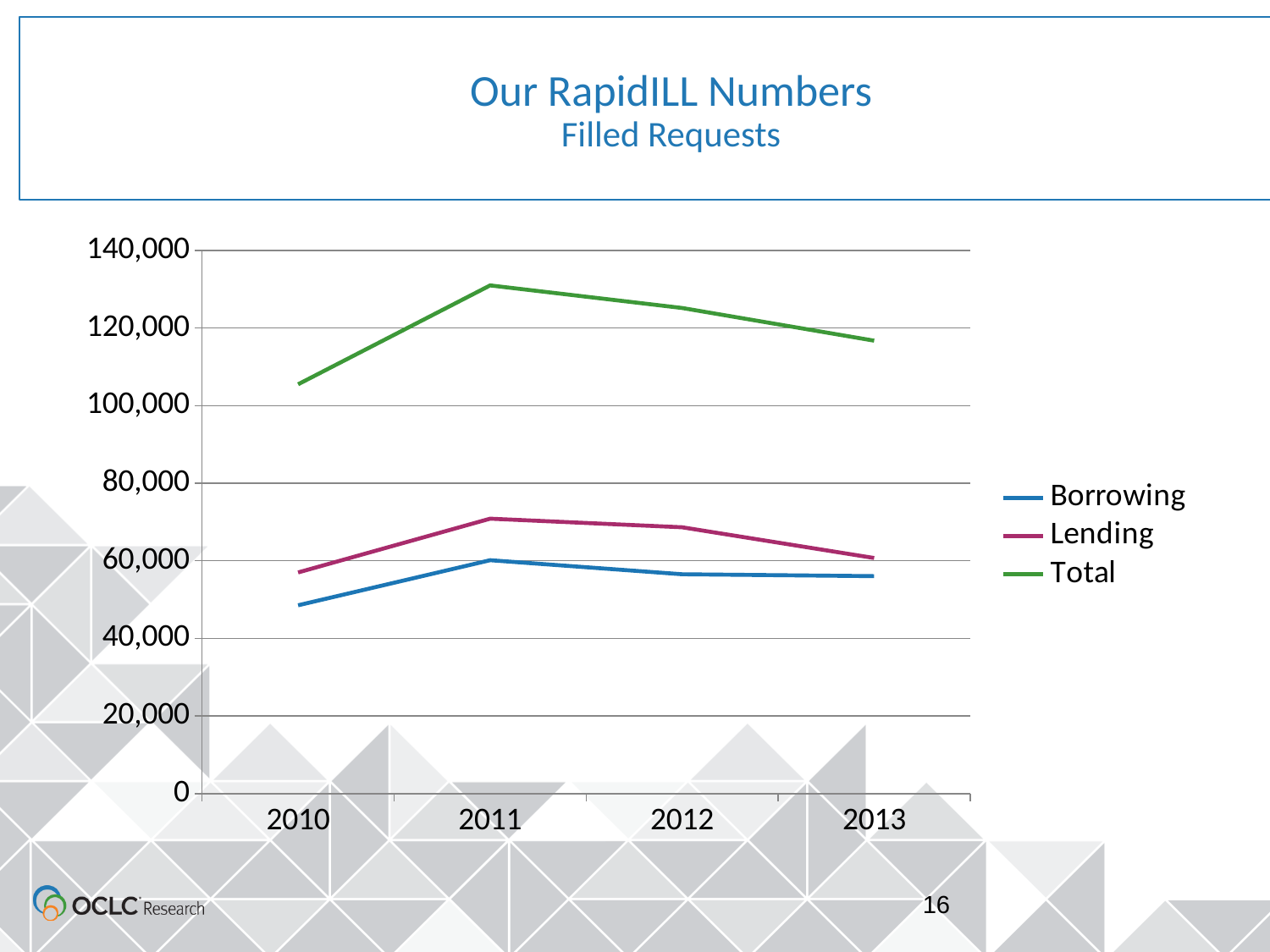
Does the Total series rise or fall from 2011 to 2013? fall Is the value for Borrowing in 2010 greater or less than 60,000? less Is the value for Lending in 2011 greater or less than 60,000? greater How many years are plotted along the x axis? 4 What kind of chart is shown on the slide? line chart In which year is the Borrowing series at its lowest? 2010 How many series does the legend list? 3 In 2012, which is larger, Lending or Borrowing? Lending In which year is the Total series at its highest? 2011 Is the value for Total in 2013 greater or less than 120,000? less